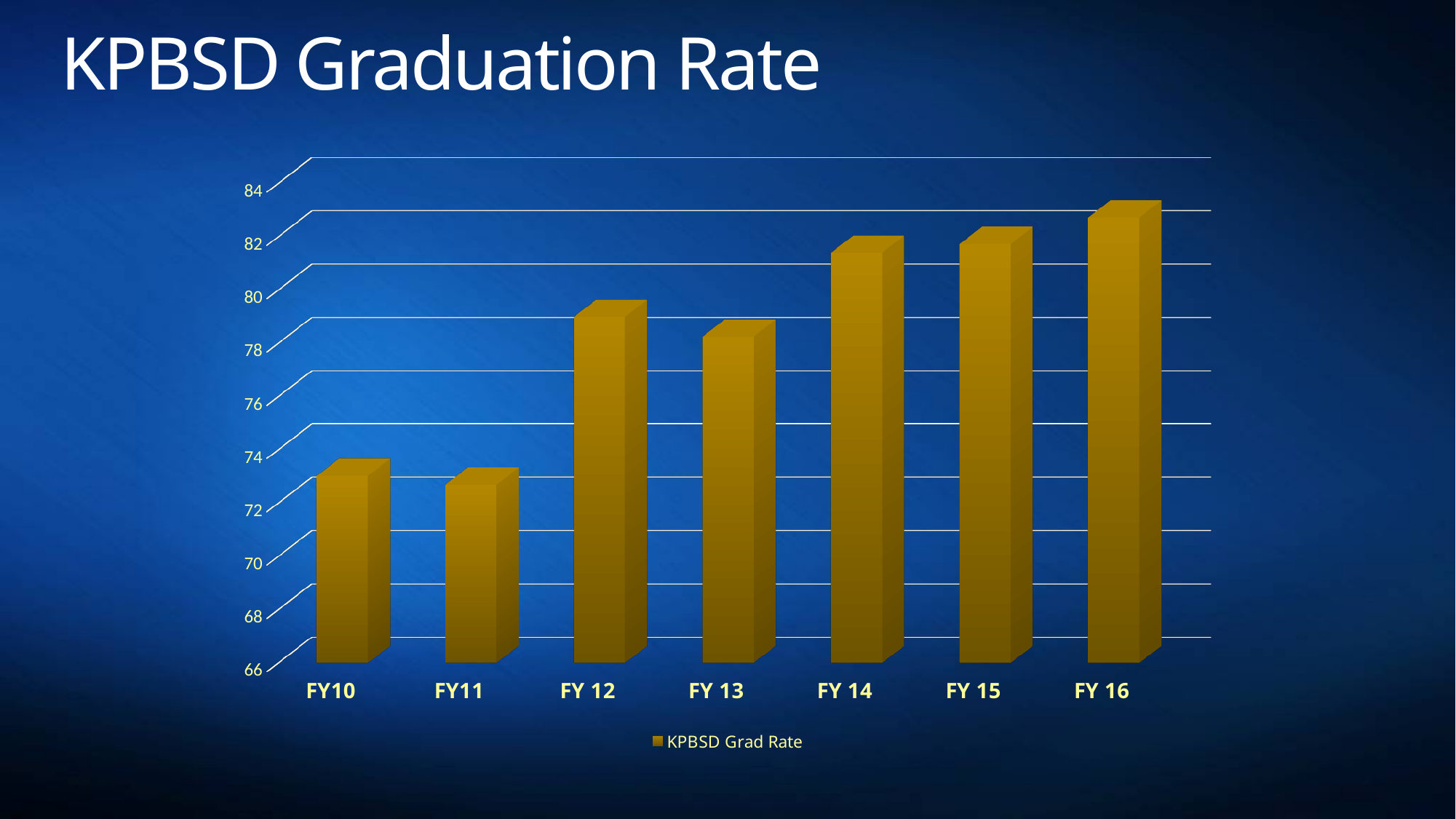
Overall, do the graduation rates rise or fall from FY10 to FY 16? rise How many series does the legend list? 1 Is the value for FY 14 greater or less than 80? greater Is the graduation rate for FY10 greater or less than FY 14? less Is the graduation rate for FY 12 greater or less than FY 13? greater Which fiscal year has the highest graduation rate? FY 16 Is the value for FY11 greater or less than 74? less Is the value for FY10 greater or less than 72? greater What kind of chart is shown on the slide? bar chart How many fiscal years are plotted on the chart? 7 What is the name of the series shown in the legend? KPBSD Grad Rate